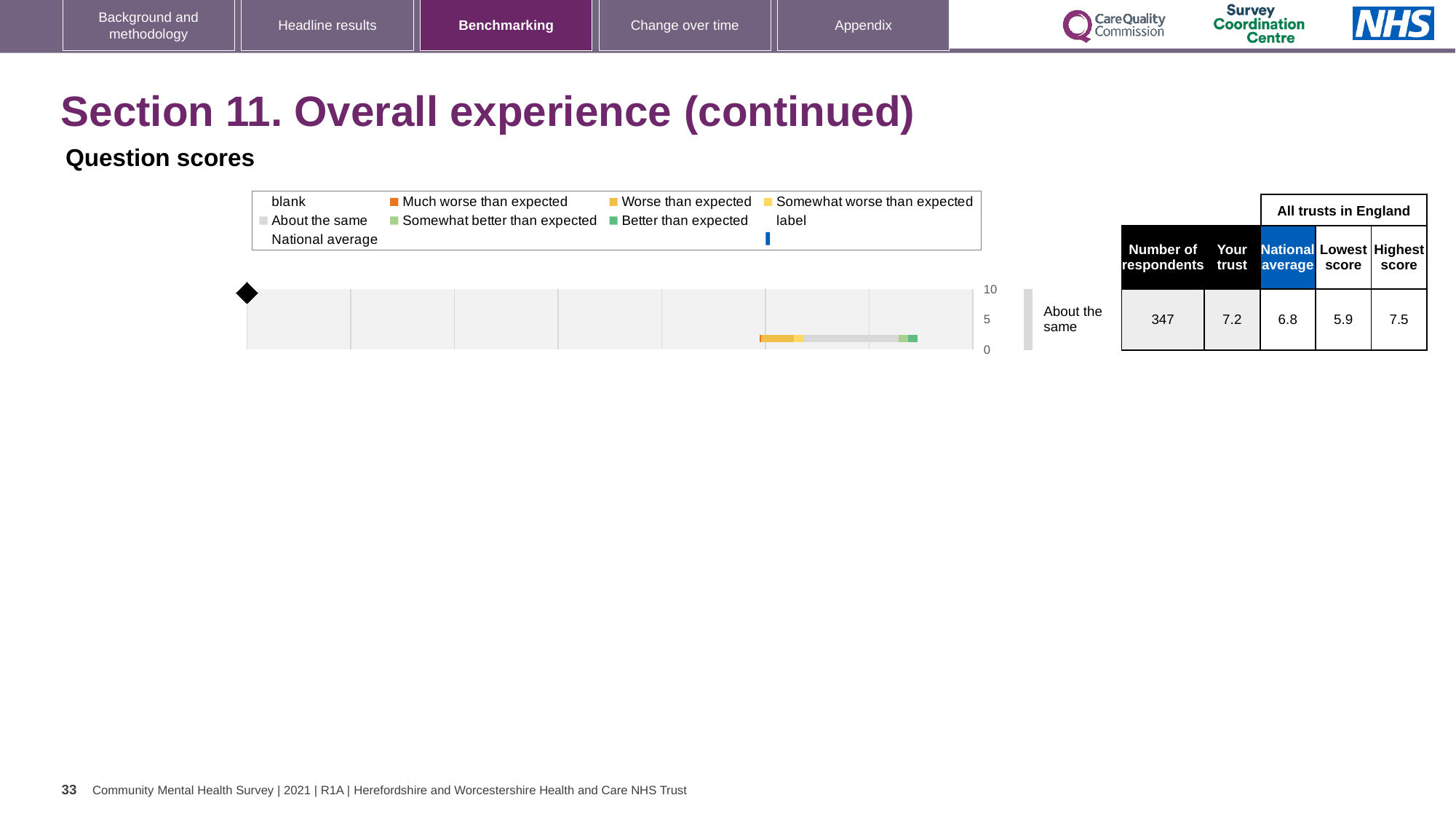
What is the difference between the 'Your trust' score and the national average score? 0.4 What kind of chart is shown under 'Question scores'? bar chart What is the maximum value shown on the chart's axis? 10 How many respondents are listed for the 'About the same' row? 347 What is the 'Your trust' score for the question labelled 'About the same'? 7.2 What is the difference between the highest score and the lowest score among all trusts in England? 1.6 How many question rows are plotted on the chart? 1 Which is larger, the 'Your trust' score or the national average score? Your trust What is the highest score among all trusts in England shown in the table? 7.5 What is the national average score shown for the 'About the same' row? 6.8 What is the lowest score among all trusts in England shown in the table? 5.9 Is the 'Your trust' score greater or less than 5 on the chart axis? greater